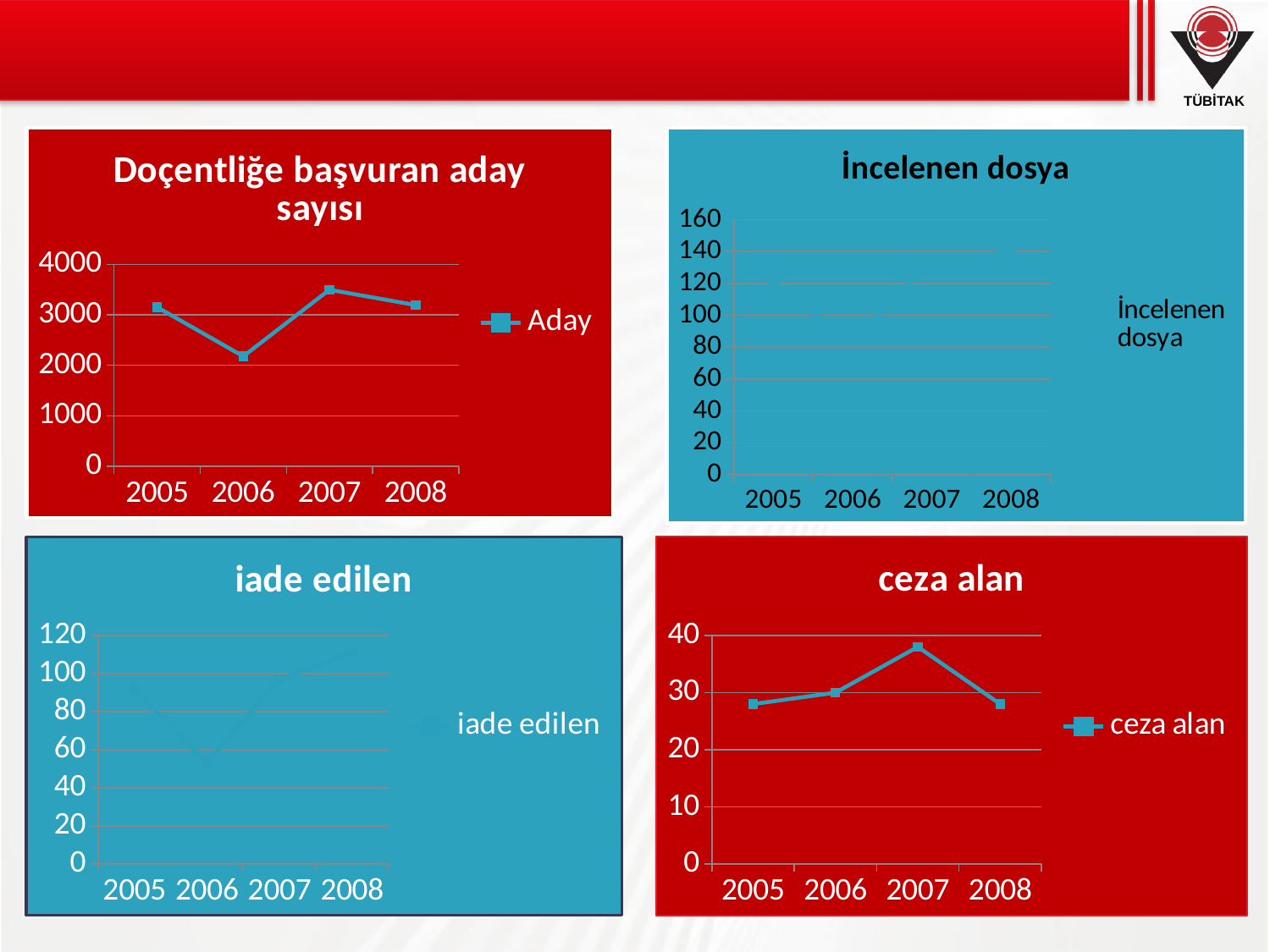
In the chart titled "ceza alan", is the value for 2007 greater or less than 30? greater In the chart titled "Doçentliğe başvuran aday sayısı", how many years are shown on the x axis? 4 How many series does the legend of the chart titled "ceza alan" list? 1 In the chart titled "ceza alan", is the value for 2005 greater or less than 30? less In the chart titled "Doçentliğe başvuran aday sayısı", is the value for 2006 greater or less than 3000? less In the chart titled "Doçentliğe başvuran aday sayısı", which year has the highest value? 2007 In the chart titled "Doçentliğe başvuran aday sayısı", which year has the lowest value? 2006 In the chart titled "ceza alan", which year has the highest value? 2007 In the chart titled "Doçentliğe başvuran aday sayısı", which is larger, the value for 2007 or the value for 2008? 2007 What is the legend entry of the chart titled "Doçentliğe başvuran aday sayısı"? Aday What kind of chart is the one titled "Doçentliğe başvuran aday sayısı"? line chart